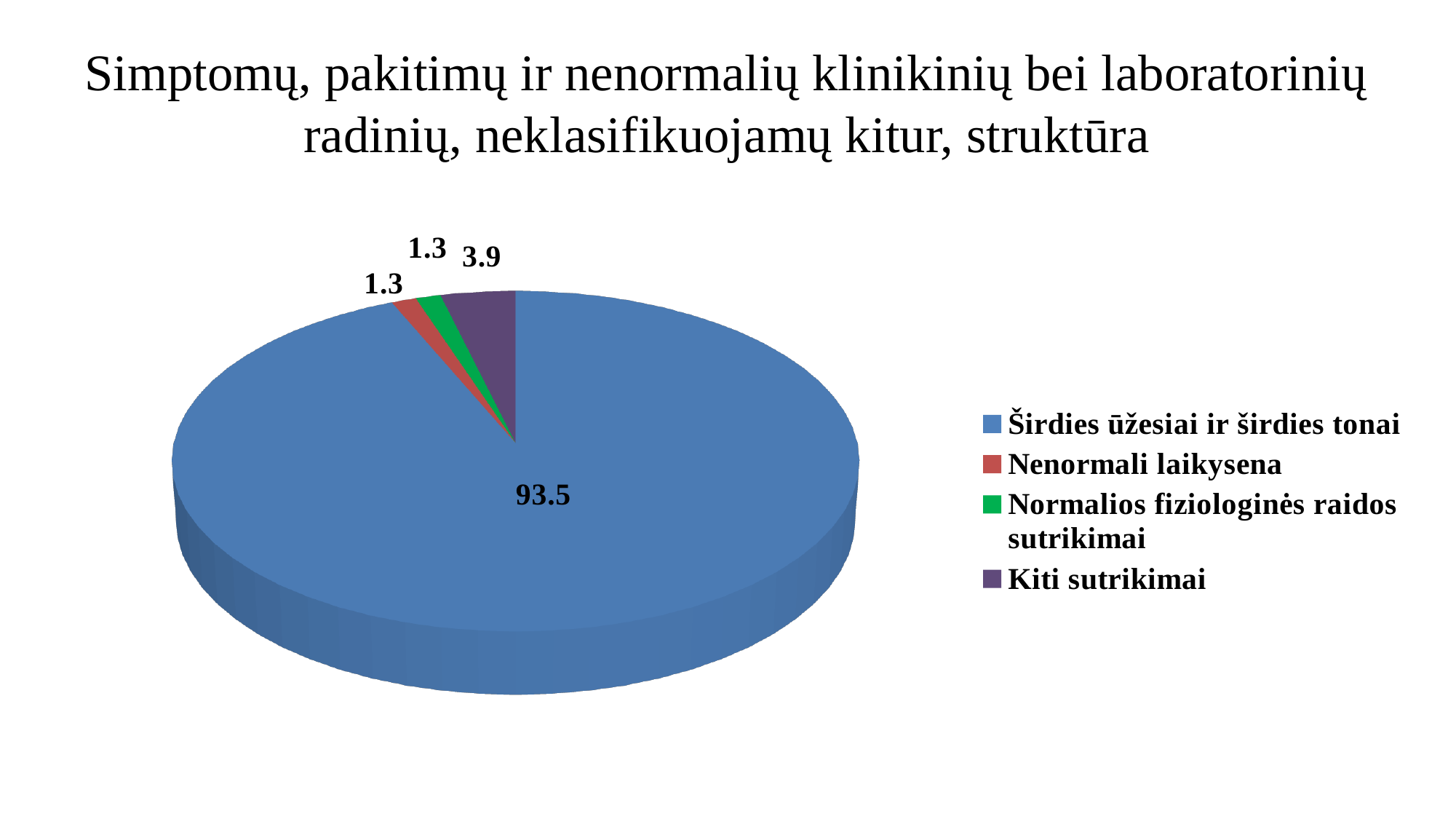
What is the difference between the value for Širdies ūžesiai ir širdies tonai and the value for Kiti sutrikimai? 89.6 What kind of chart is shown on the slide? pie chart What is the value for Širdies ūžesiai ir širdies tonai? 93.5 What colour is the slice for Kiti sutrikimai? purple What is the value for Normalios fiziologinės raidos sutrikimai? 1.3 What colour is the slice for Normalios fiziologinės raidos sutrikimai? green How many entries does the legend list? 4 Which is larger, the value for Kiti sutrikimai or the value for Nenormali laikysena? Kiti sutrikimai What is the value for Nenormali laikysena? 1.3 Which category has the largest slice of the pie? Širdies ūžesiai ir širdies tonai What is the value for Kiti sutrikimai? 3.9 How many slices does the pie chart have? 4